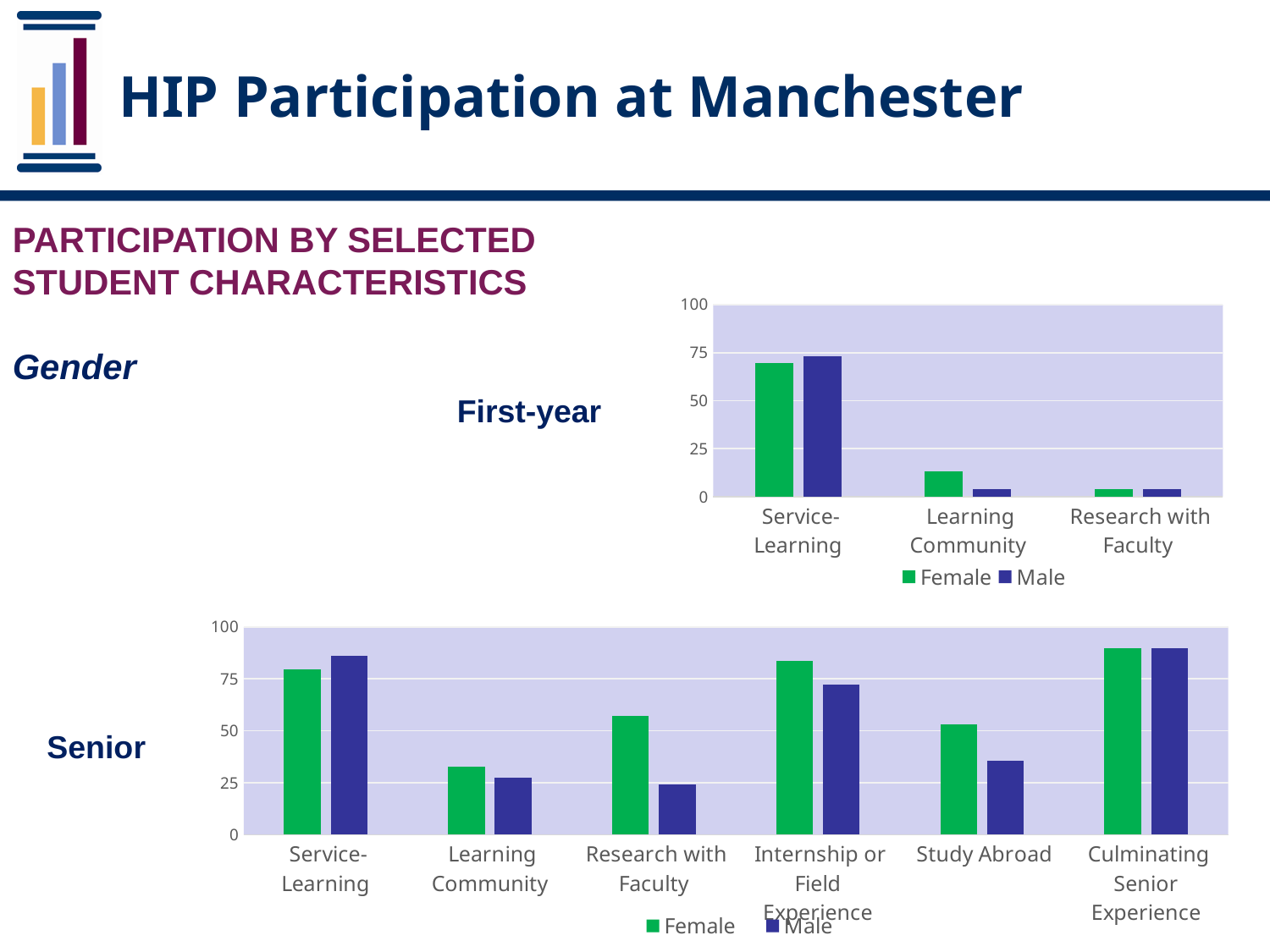
In the Senior chart, which is larger for Research with Faculty, the Female value or the Male value? Female In the First-year chart, is the Female value for Service-Learning greater or less than 50? greater In the Senior chart, which series is shown in green? Female How many categories does the First-year chart show? 3 What kind of chart is the First-year chart? bar chart How many series does the legend of the Senior chart list? 2 In the First-year chart, which category has the highest Female value? Service-Learning In the Senior chart, is the Female value for Research with Faculty greater or less than 50? greater In the Senior chart, is the Male value for Study Abroad greater or less than 50? less How many categories does the Senior chart show? 6 In the Senior chart, which category has the lowest Male value? Research with Faculty